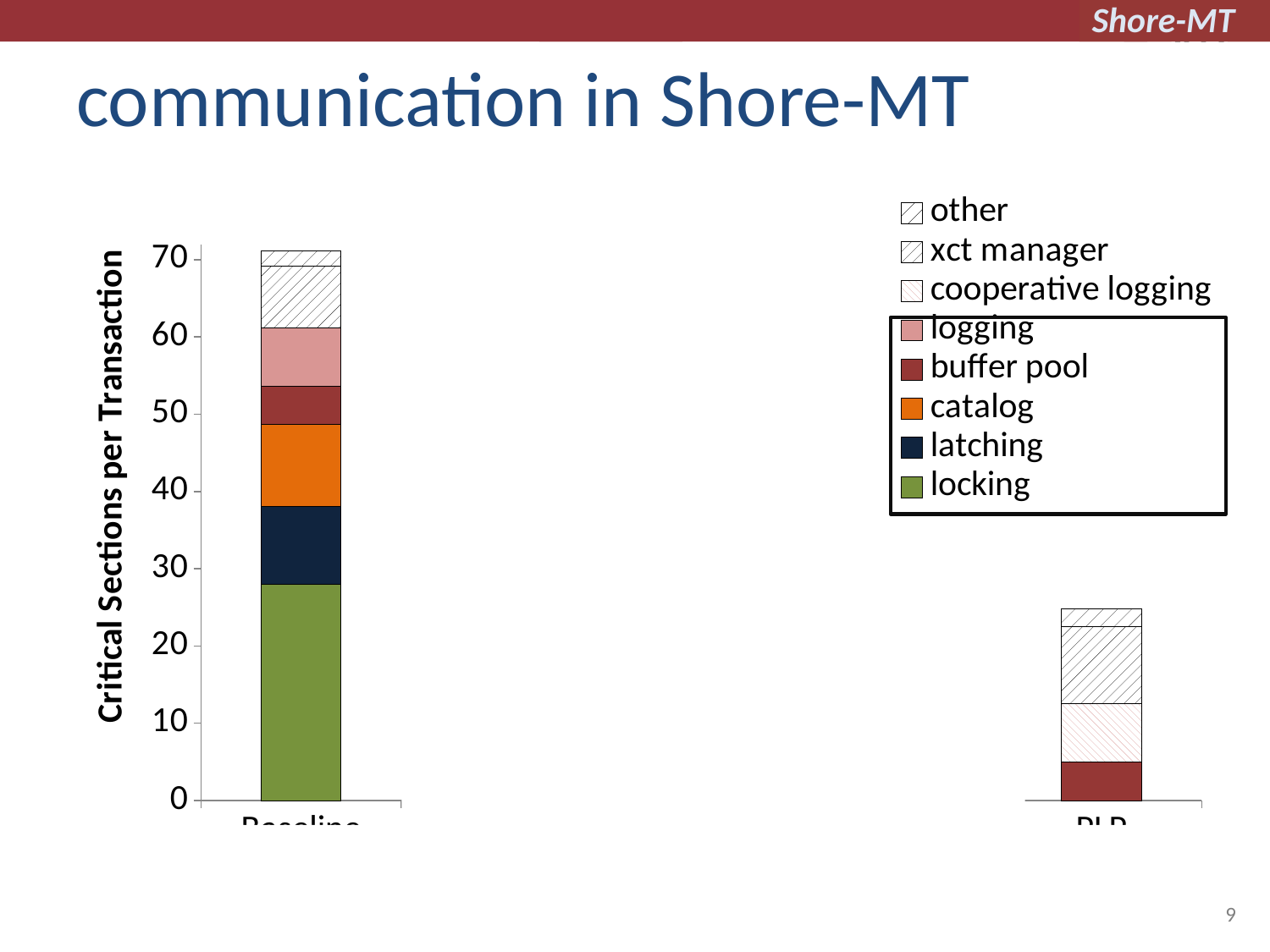
Is the locking segment of the Baseline bar greater or less than 30? less Is the total height of the Baseline bar greater or less than 60? greater Which legend entry is shown in green? locking In the Baseline bar, which segment is larger: catalog or buffer pool? catalog What is the title of the vertical axis? Critical Sections per Transaction Is the locking segment of the Baseline bar greater or less than 20? greater Which segment is the largest in the Baseline bar? locking How many series does the legend list? 8 What kind of chart is shown on the slide? bar chart How many bars are plotted on the slide? 2 In the Baseline bar, which segment is larger: locking or latching? locking